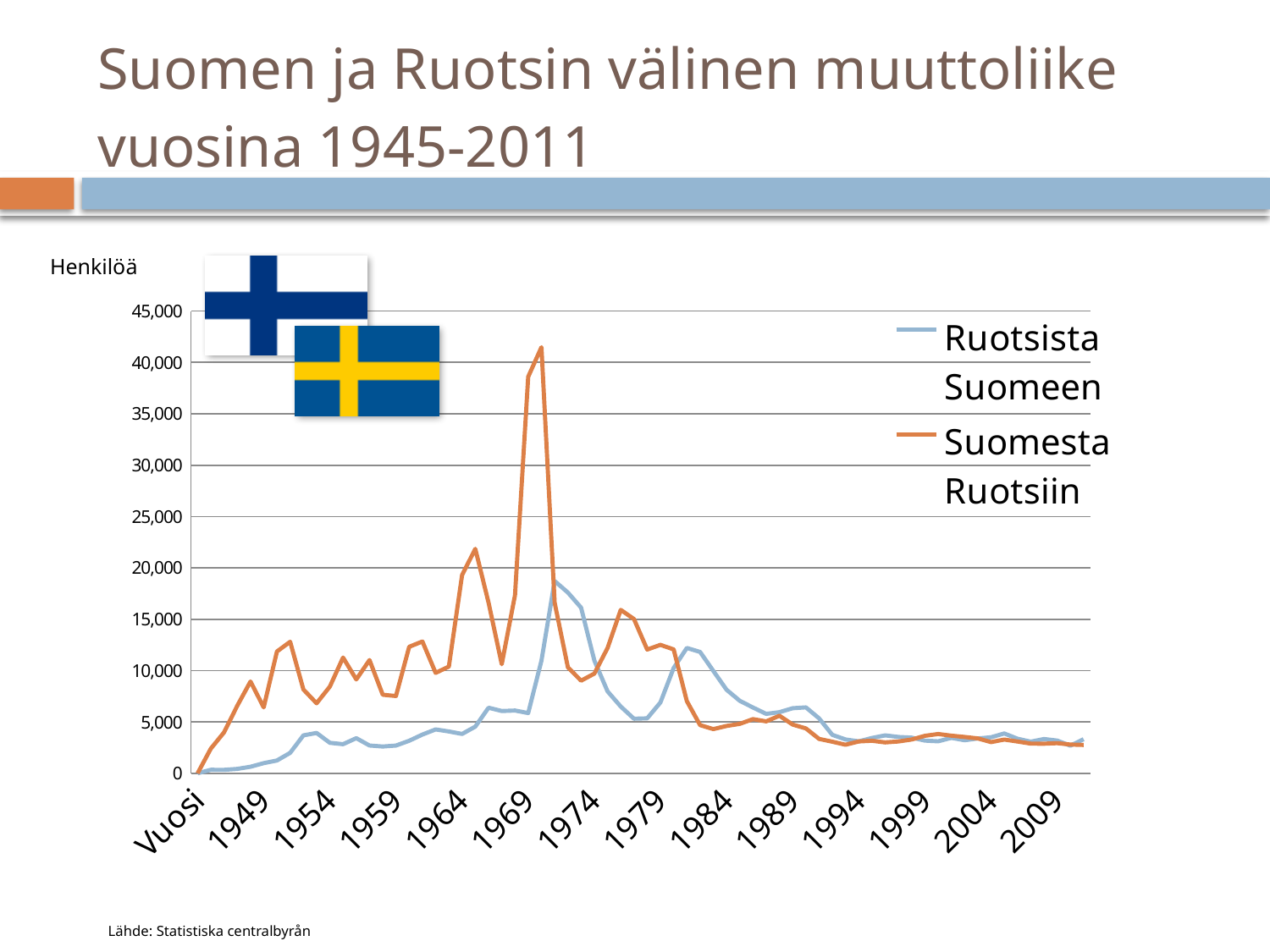
In 1974, which series has the larger value, Ruotsista Suomeen or Suomesta Ruotsiin? Ruotsista Suomeen In 1949, which series has the larger value, Ruotsista Suomeen or Suomesta Ruotsiin? Suomesta Ruotsiin Is the peak value of the Suomesta Ruotsiin series greater or less than 40,000? greater Is the peak value of the Ruotsista Suomeen series greater or less than 20,000? less Which series reaches the highest value anywhere on the chart? Suomesta Ruotsiin How many series does the legend list? 2 What are the two series named in the legend? Ruotsista Suomeen and Suomesta Ruotsiin Does the Suomesta Ruotsiin series generally rise or fall between 1974 and 1994? fall What is the label on the vertical axis of the chart? Henkilöä What kind of chart is shown on the slide? line chart Is the value for Suomesta Ruotsiin in 1949 greater or less than 5,000? greater